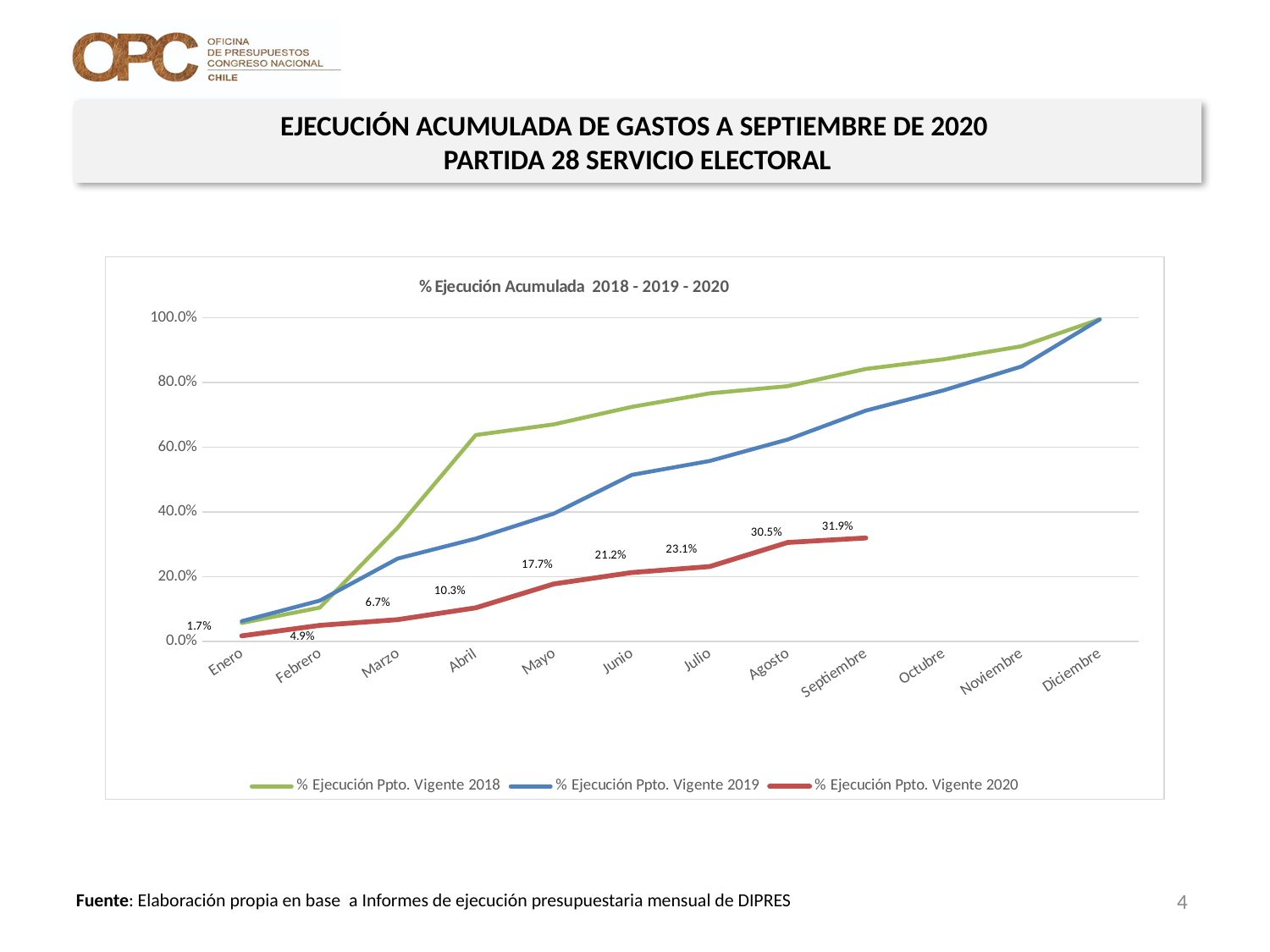
In Abril, which series has the larger value: % Ejecución Ppto. Vigente 2018 or % Ejecución Ppto. Vigente 2019? % Ejecución Ppto. Vigente 2018 Which month has the highest value for % Ejecución Ppto. Vigente 2020? Septiembre Is the value for % Ejecución Ppto. Vigente 2019 in Junio greater or less than 60.0%? less What is the difference between the 2020 values for Septiembre and Agosto? 1.4% What is the value of % Ejecución Ppto. Vigente 2020 for Septiembre? 31.9% What is the value of % Ejecución Ppto. Vigente 2020 for Enero? 1.7% What is the value of % Ejecución Ppto. Vigente 2020 for Mayo? 17.7% How many months are shown on the x axis? 12 What kind of chart is shown on the slide? line chart Is the value for % Ejecución Ppto. Vigente 2018 in Abril greater or less than 60.0%? greater What is the difference between the 2020 values for Mayo and Abril? 7.4% How many series does the chart legend list? 3